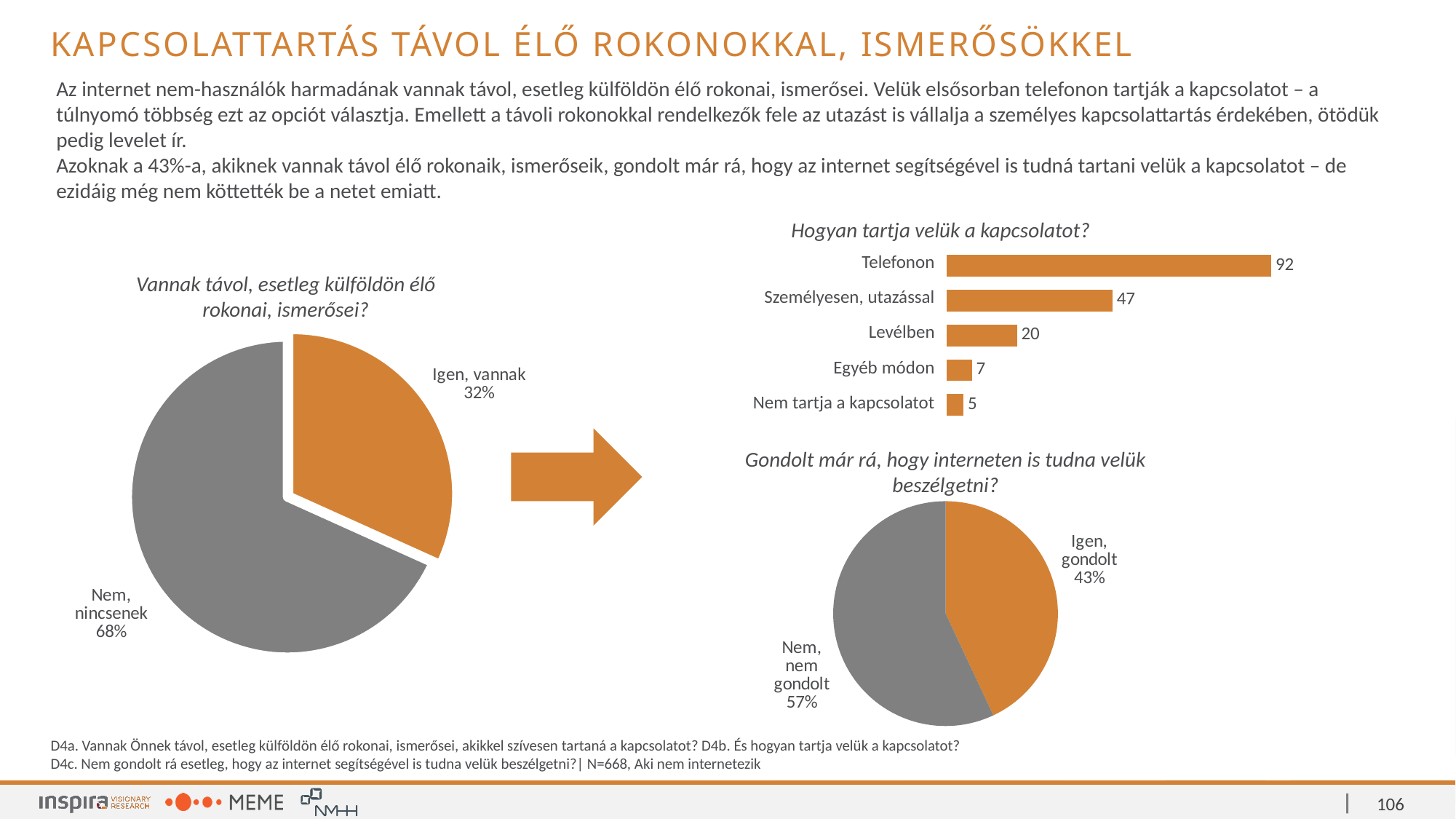
In the pie chart 'Gondolt már rá, hogy interneten is tudna velük beszélgetni?', what share is 'Igen, gondolt'? 43% In the chart 'Hogyan tartja velük a kapcsolatot?', what is the value for Levélben? 20 In the pie chart 'Gondolt már rá, hogy interneten is tudna velük beszélgetni?', which slice is larger: 'Igen, gondolt' or 'Nem, nem gondolt'? Nem, nem gondolt In the chart 'Hogyan tartja velük a kapcsolatot?', which is larger: Egyéb módon or Nem tartja a kapcsolatot? Egyéb módon In the pie chart 'Vannak távol, esetleg külföldön élő rokonai, ismerősei?', what share is 'Igen, vannak'? 32% How many categories are shown in the chart 'Hogyan tartja velük a kapcsolatot?'? 5 In the pie chart 'Vannak távol, esetleg külföldön élő rokonai, ismerősei?', what share is 'Nem, nincsenek'? 68% In the chart 'Hogyan tartja velük a kapcsolatot?', what is the difference between Telefonon and Személyesen, utazással? 45 In the chart 'Hogyan tartja velük a kapcsolatot?', what is the value for Telefonon? 92 In the chart 'Hogyan tartja velük a kapcsolatot?', which category has the lowest value? Nem tartja a kapcsolatot What kind of chart is 'Hogyan tartja velük a kapcsolatot?'? bar chart In the chart 'Hogyan tartja velük a kapcsolatot?', which category has the highest value? Telefonon